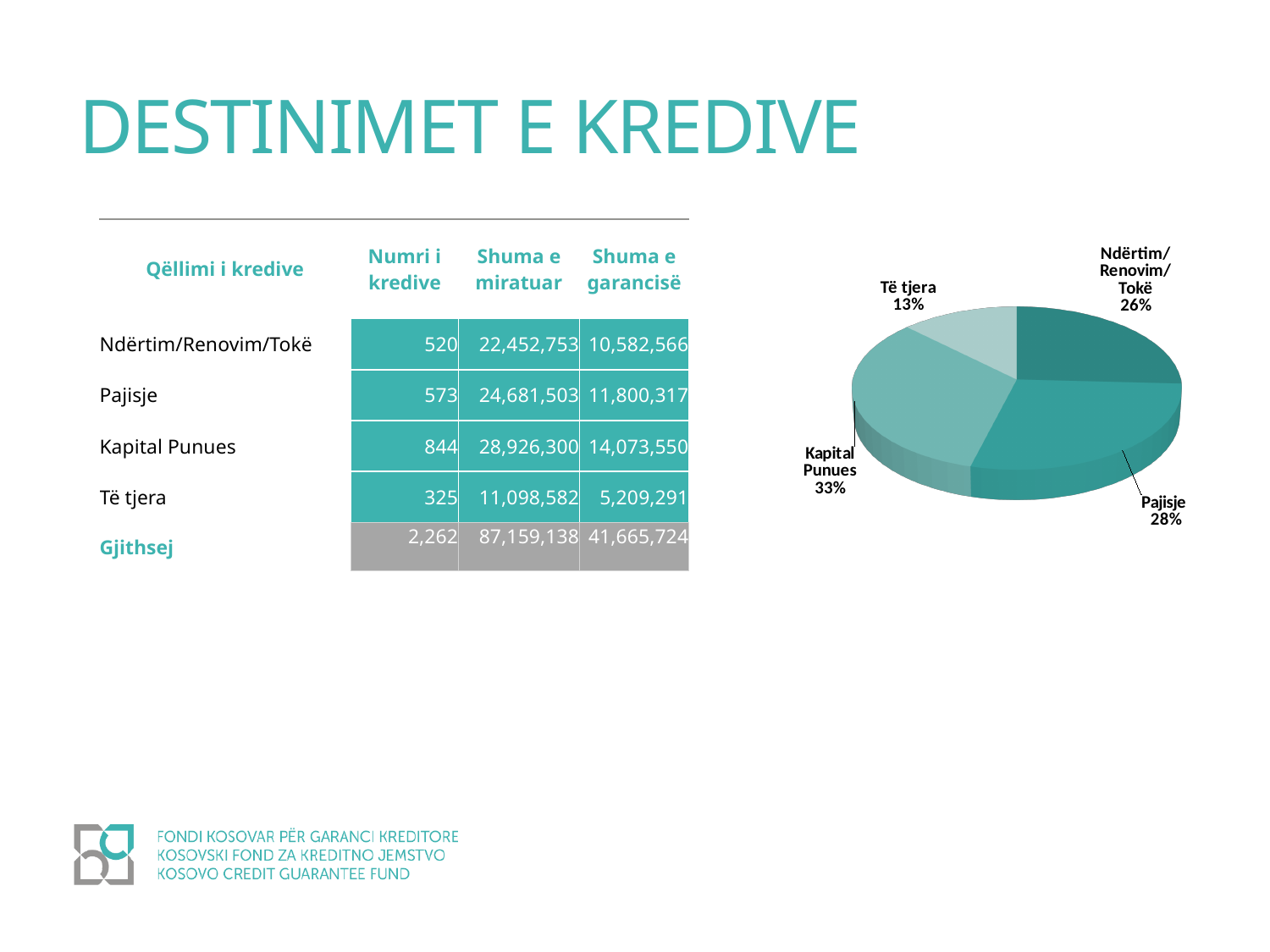
In the pie chart, which is larger: the share for Pajisje or the share for Ndërtim/Renovim/Tokë? Pajisje What kind of chart is shown on the slide? Pie chart What is the title of the slide containing the pie chart? DESTINIMET E KREDIVE In the pie chart, what is the difference in percentage points between the Kapital Punues share and the Të tjera share? 20 percentage points Which slice of the pie chart is the smallest? Të tjera In the pie chart, what share is labelled for Pajisje? 28% Which slice of the pie chart is the largest? Kapital Punues In the pie chart, what share is labelled for Kapital Punues? 33% In the pie chart, what share is labelled for Ndërtim/Renovim/Tokë? 26% In the pie chart, what is the difference in percentage points between the Pajisje share and the Ndërtim/Renovim/Tokë share? 2 percentage points How many slices does the pie chart have? 4